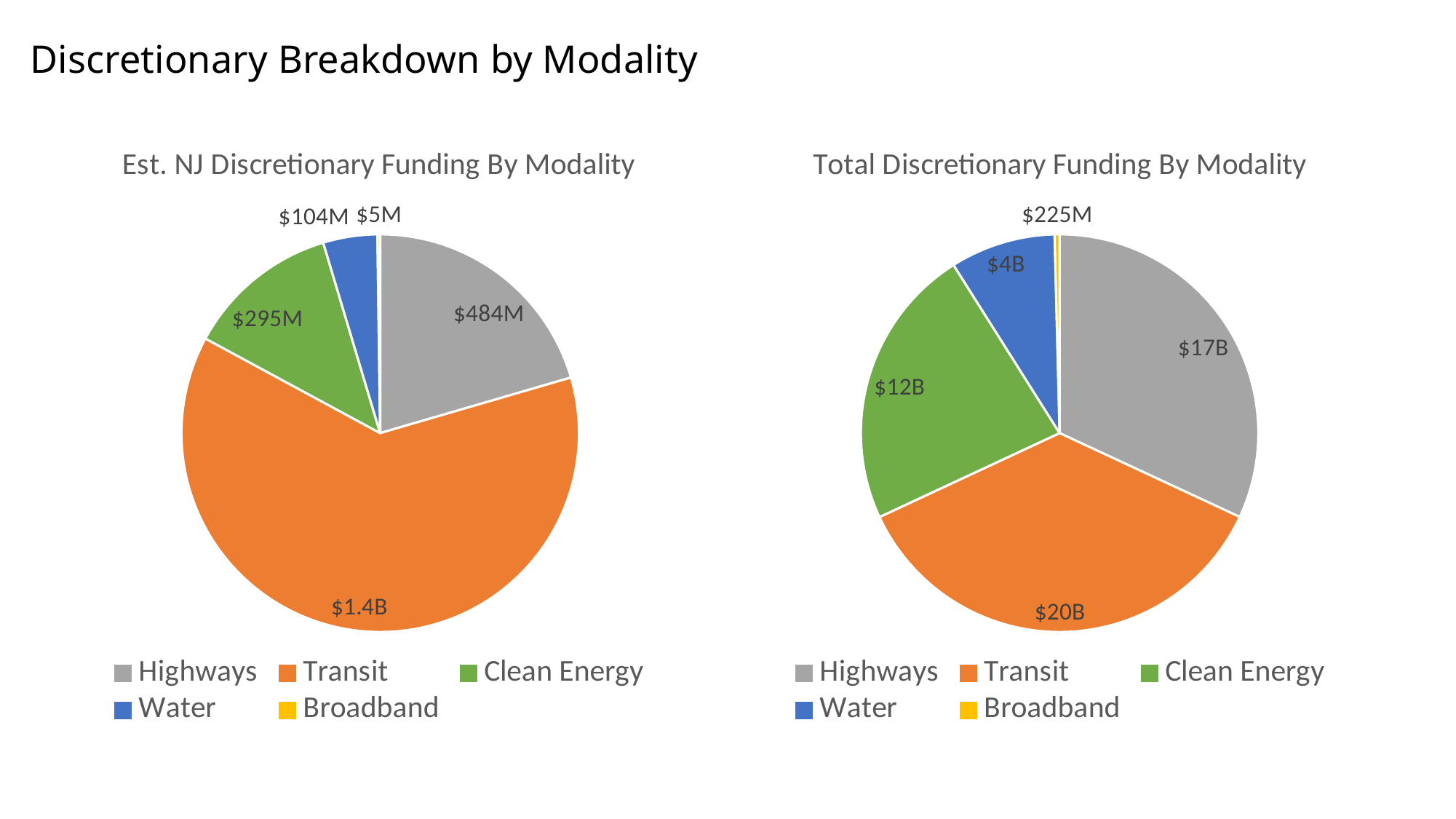
In the 'Total Discretionary Funding By Modality' chart, what is the value for Clean Energy? $12B In the 'Est. NJ Discretionary Funding By Modality' chart, what is the value for Broadband? $5M In the 'Est. NJ Discretionary Funding By Modality' chart, what is the difference between Highways and Clean Energy? $189M In the 'Total Discretionary Funding By Modality' chart, what is the value for Broadband? $225M What type of chart is the 'Total Discretionary Funding By Modality' chart? Pie chart How many modalities does the legend of the 'Est. NJ Discretionary Funding By Modality' chart list? 5 In the 'Est. NJ Discretionary Funding By Modality' chart, what is the value for Highways? $484M In the 'Est. NJ Discretionary Funding By Modality' chart, what is the value for Transit? $1.4B In the 'Total Discretionary Funding By Modality' chart, what is the difference between Highways and Clean Energy? $5B In the 'Total Discretionary Funding By Modality' chart, which is larger, Highways or Water? Highways In the 'Total Discretionary Funding By Modality' chart, which modality has the largest slice? Transit In the 'Est. NJ Discretionary Funding By Modality' chart, which modality has the smallest slice? Broadband